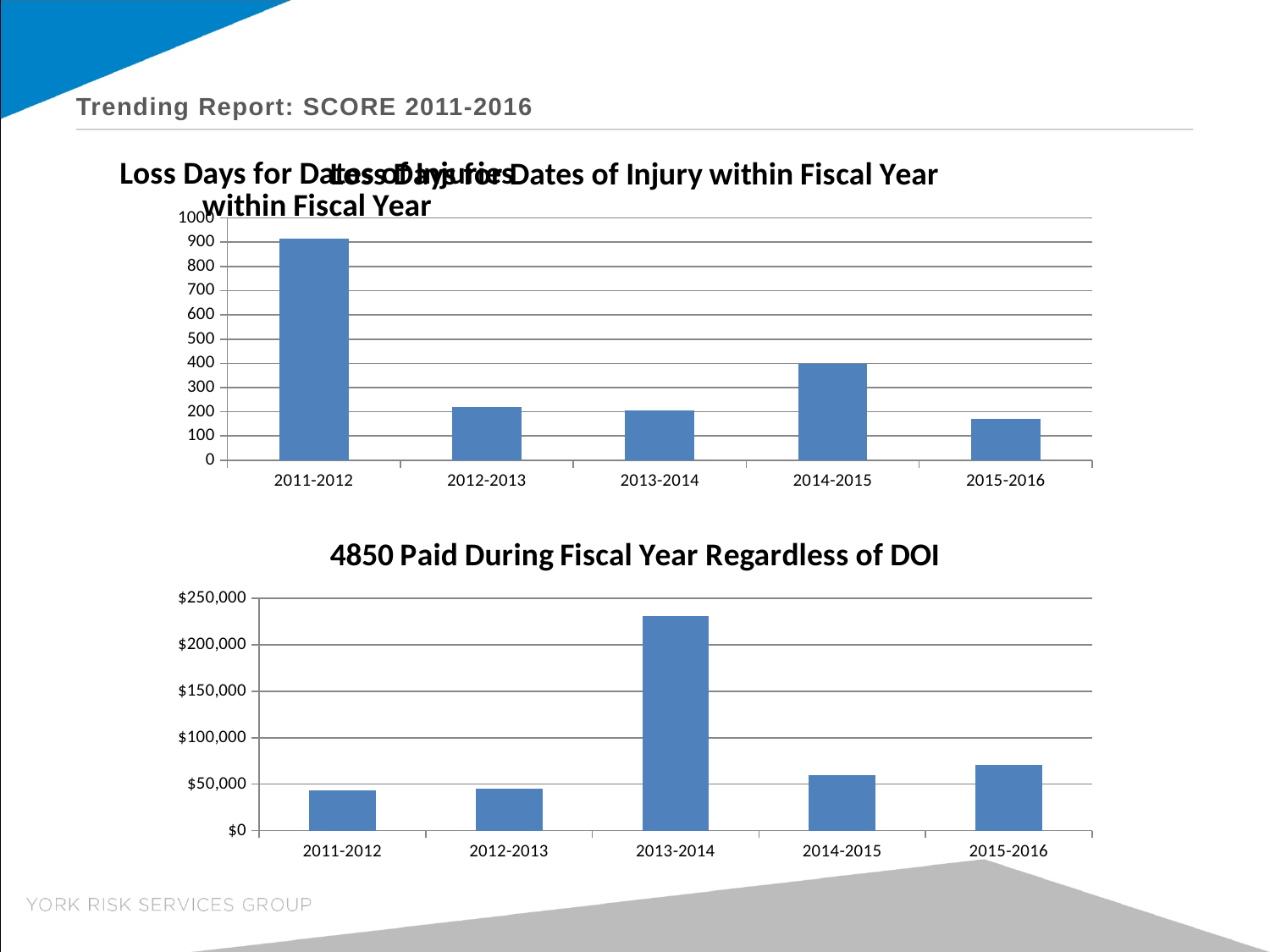
How many fiscal years are shown on the x axis of the top chart? 5 In the chart titled '4850 Paid During Fiscal Year Regardless of DOI', which fiscal year has the highest value? 2013-2014 In the chart titled '4850 Paid During Fiscal Year Regardless of DOI', is the value for 2013-2014 greater or less than $200,000? greater In the top chart, which fiscal year has the highest number of loss days? 2011-2012 In the chart titled '4850 Paid During Fiscal Year Regardless of DOI', is the value for 2011-2012 greater or less than $50,000? less In the top chart, is the value for 2015-2016 greater or less than 200? less What kind of chart is the bottom chart on the slide? bar chart In the top chart, which fiscal year has the lowest number of loss days? 2015-2016 In the top chart, which is larger, the value for 2014-2015 or the value for 2012-2013? 2014-2015 In the chart titled '4850 Paid During Fiscal Year Regardless of DOI', which is larger, the value for 2015-2016 or the value for 2011-2012? 2015-2016